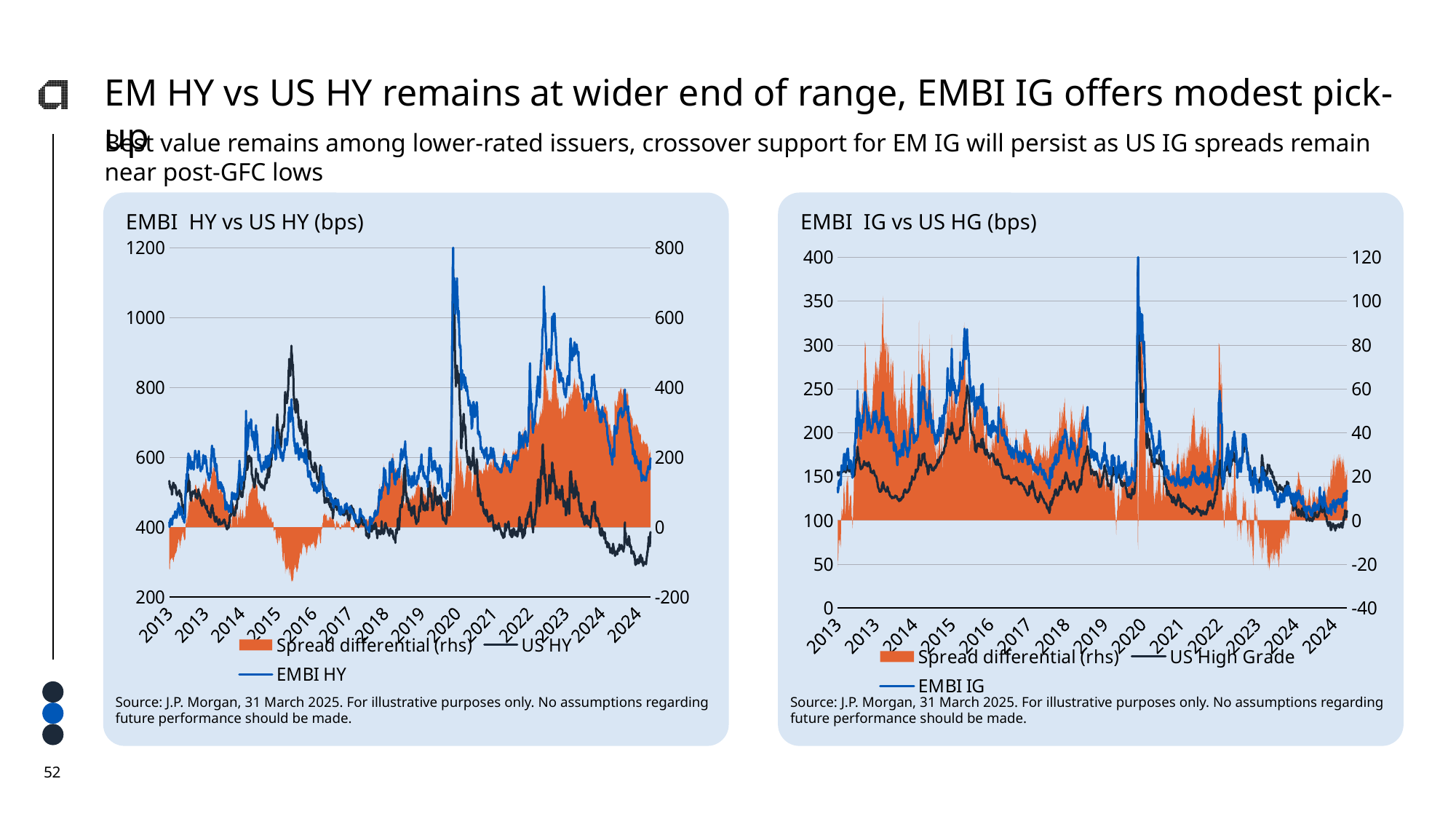
What are the legend entries of the 'EMBI HY vs US HY (bps)' chart? Spread differential (rhs), US HY, EMBI HY How many series does the legend of the 'EMBI HY vs US HY (bps)' chart list? 3 What is the title of the chart on the right side of the slide? EMBI IG vs US HG (bps) In the 'EMBI HY vs US HY (bps)' chart, is the peak value of EMBI HY in 2020 greater or less than 1000? greater In the 'EMBI IG vs US HG (bps)' chart, which series reaches the higher peak in 2020, EMBI IG or US High Grade? EMBI IG In the 'EMBI HY vs US HY (bps)' chart, is the spread differential (rhs) around 2015-2016 greater or less than 0? less What kind of chart is the 'EMBI HY vs US HY (bps)' chart? line chart In the 'EMBI IG vs US HG (bps)' chart, is the peak value of EMBI IG in 2020 greater or less than 350? greater How many series does the legend of the 'EMBI IG vs US HG (bps)' chart list? 3